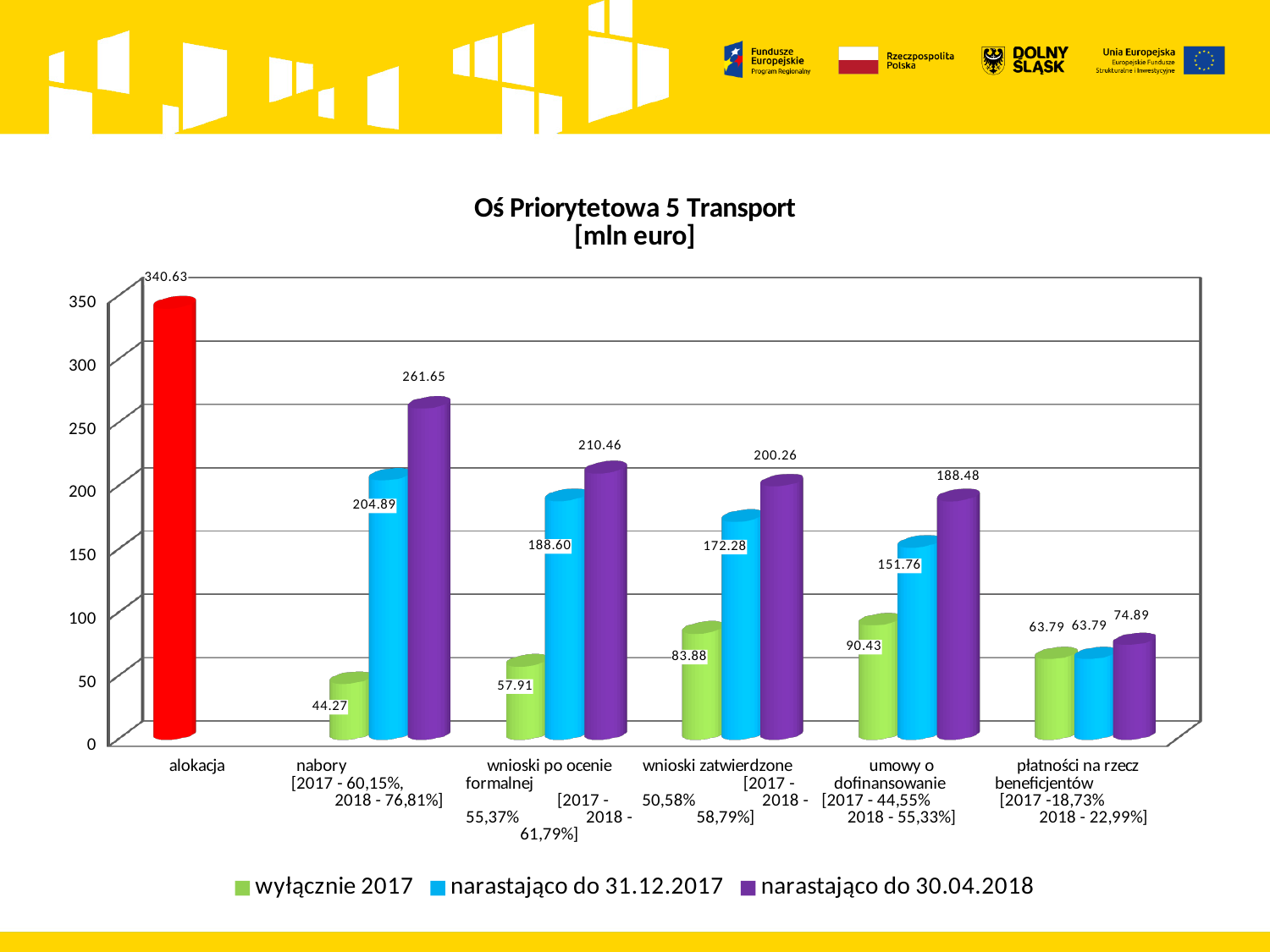
What is the difference between the narastająco do 30.04.2018 and narastająco do 31.12.2017 values for wnioski po ocenie formalnej? 21.86 How many series does the legend list? 3 What is the title of the chart? Oś Priorytetowa 5 Transport [mln euro] Which category has the lowest value in the series narastająco do 30.04.2018? płatności na rzecz beneficjentów What is the value of alokacja? 340.63 What is the value for wnioski zatwierdzone in the series narastająco do 31.12.2017? 172.28 Which is larger: the wyłącznie 2017 value for wnioski zatwierdzone or for płatności na rzecz beneficjentów? wnioski zatwierdzone What is the value for umowy o dofinansowanie in the series wyłącznie 2017? 90.43 What is the value for nabory in the series narastająco do 30.04.2018? 261.65 What kind of chart is shown? bar chart How many categories are shown on the x axis? 6